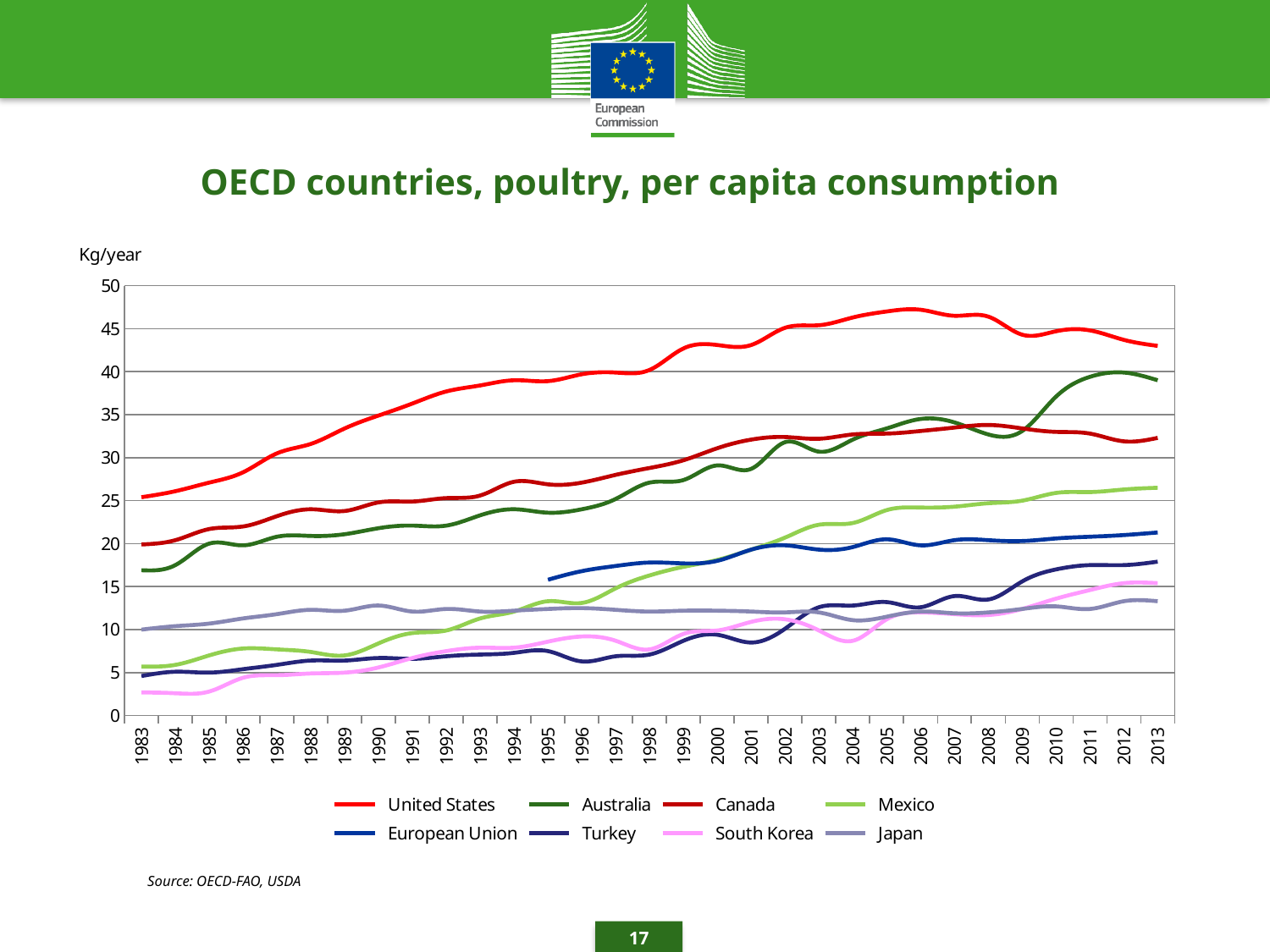
How many series does the legend list? 8 What unit is shown on the y axis of the chart? Kg/year What kind of chart is shown on the slide? line chart How many years are shown along the x axis? 31 In 2013, which is larger, the value for Australia or the value for Canada? Australia In 2013, which is larger, the value for Mexico or the value for the European Union? Mexico Is the value for Japan in 2013 greater or less than 15? less Which country has the lowest poultry per capita consumption in 1983? South Korea Does the value for the United States rise or fall overall from 1983 to 2013? rise Which country has the highest poultry per capita consumption in 2013? United States Is the value for the United States in 2013 greater or less than 40? greater Is the value for Mexico in 2013 greater or less than 25? greater